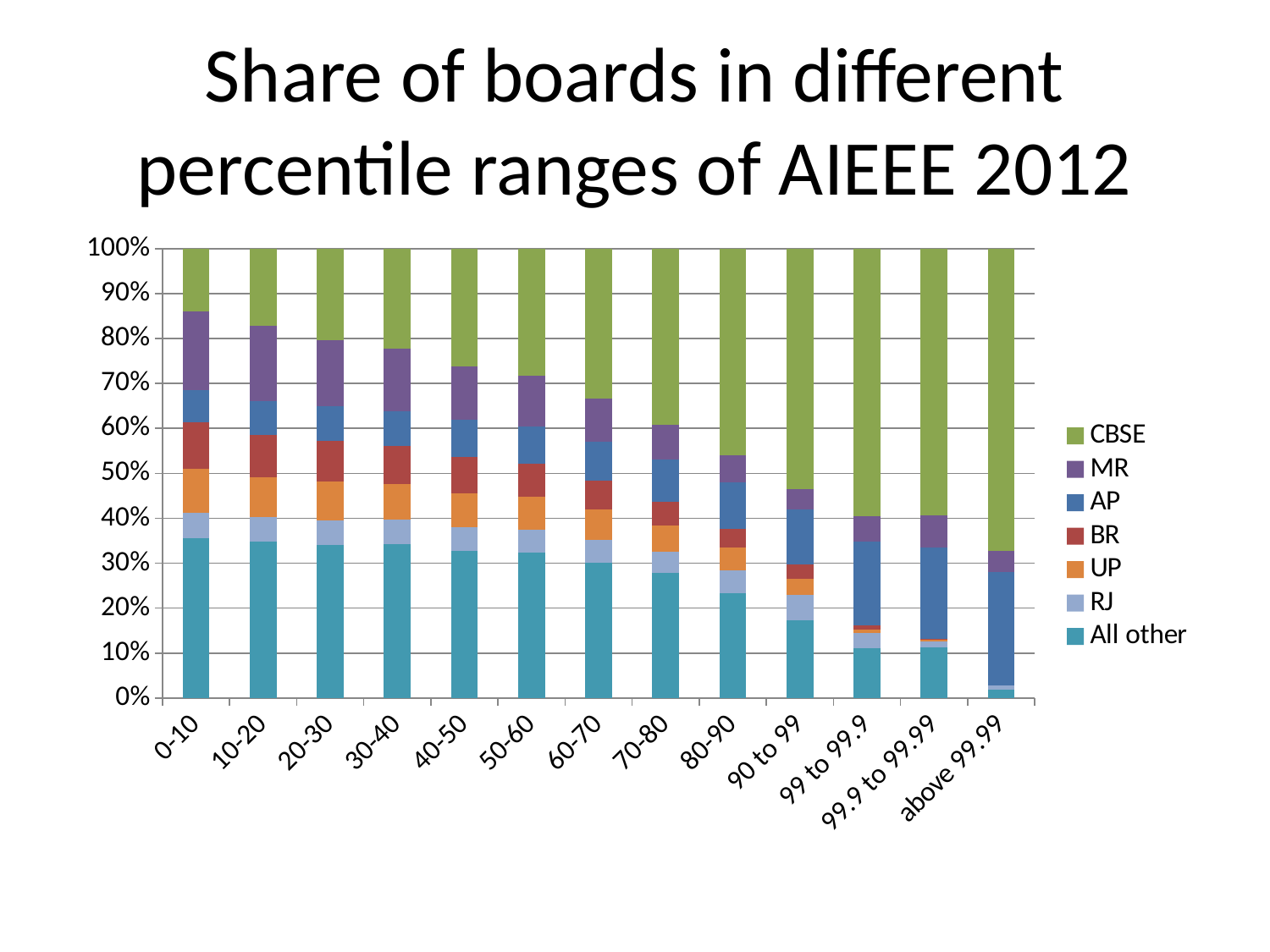
Is the value for All other in the 90 to 99 percentile range greater or less than 20%? less What is the total of the stacked bar for the 0-10 percentile range? 100% Is the value for All other in the 0-10 percentile range greater or less than 30%? greater Does the CBSE share rise or fall as you move from 0-10 to above 99.99 along the x axis? rise What is the title of the chart? Share of boards in different percentile ranges of AIEEE 2012 Which is larger, the All other share in the 0-10 range or in the above 99.99 range? 0-10 Does the All other share rise or fall as you move from 0-10 to above 99.99 along the x axis? fall How many percentile range categories are shown on the x axis? 13 What kind of chart is shown on the slide? Stacked bar chart Is the value for All other in the above 99.99 percentile range greater or less than 10%? less Which percentile range has the smallest All other share? above 99.99 How many series does the legend list? 7